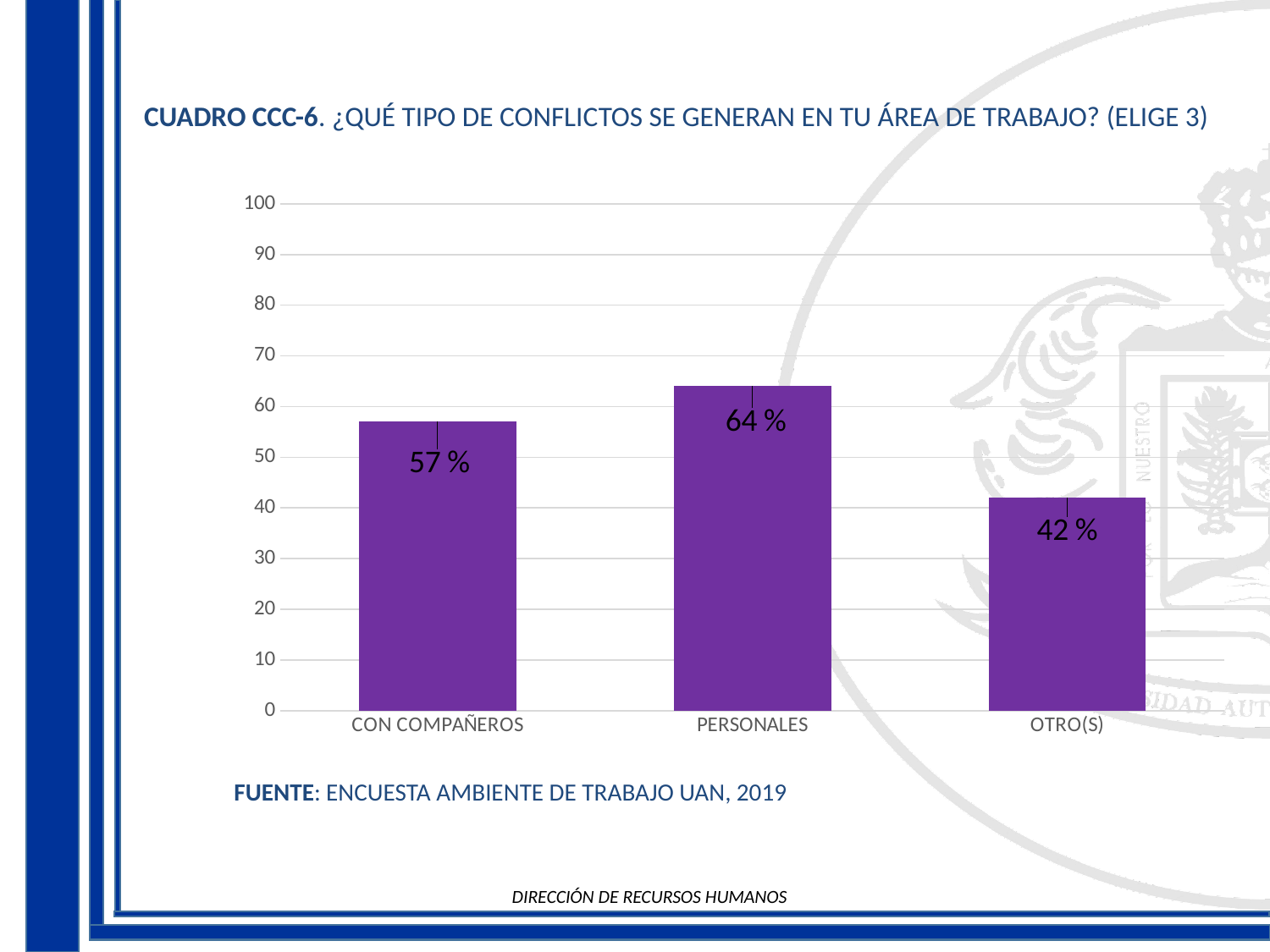
What kind of chart is shown on the slide? Bar chart What is the difference between the values for PERSONALES and CON COMPAÑEROS? 7 % What is the difference between the values for CON COMPAÑEROS and OTRO(S)? 15 % What is the source cited below the chart? ENCUESTA AMBIENTE DE TRABAJO UAN, 2019 How many categories are shown in the chart? 3 Which category has the highest value? PERSONALES What is the value for PERSONALES? 64 % Is the value for PERSONALES greater or less than 60? greater Which category has the lowest value? OTRO(S) What is the value for CON COMPAÑEROS? 57 % What is the value for OTRO(S)? 42 % Which is larger, the value for CON COMPAÑEROS or the value for OTRO(S)? CON COMPAÑEROS